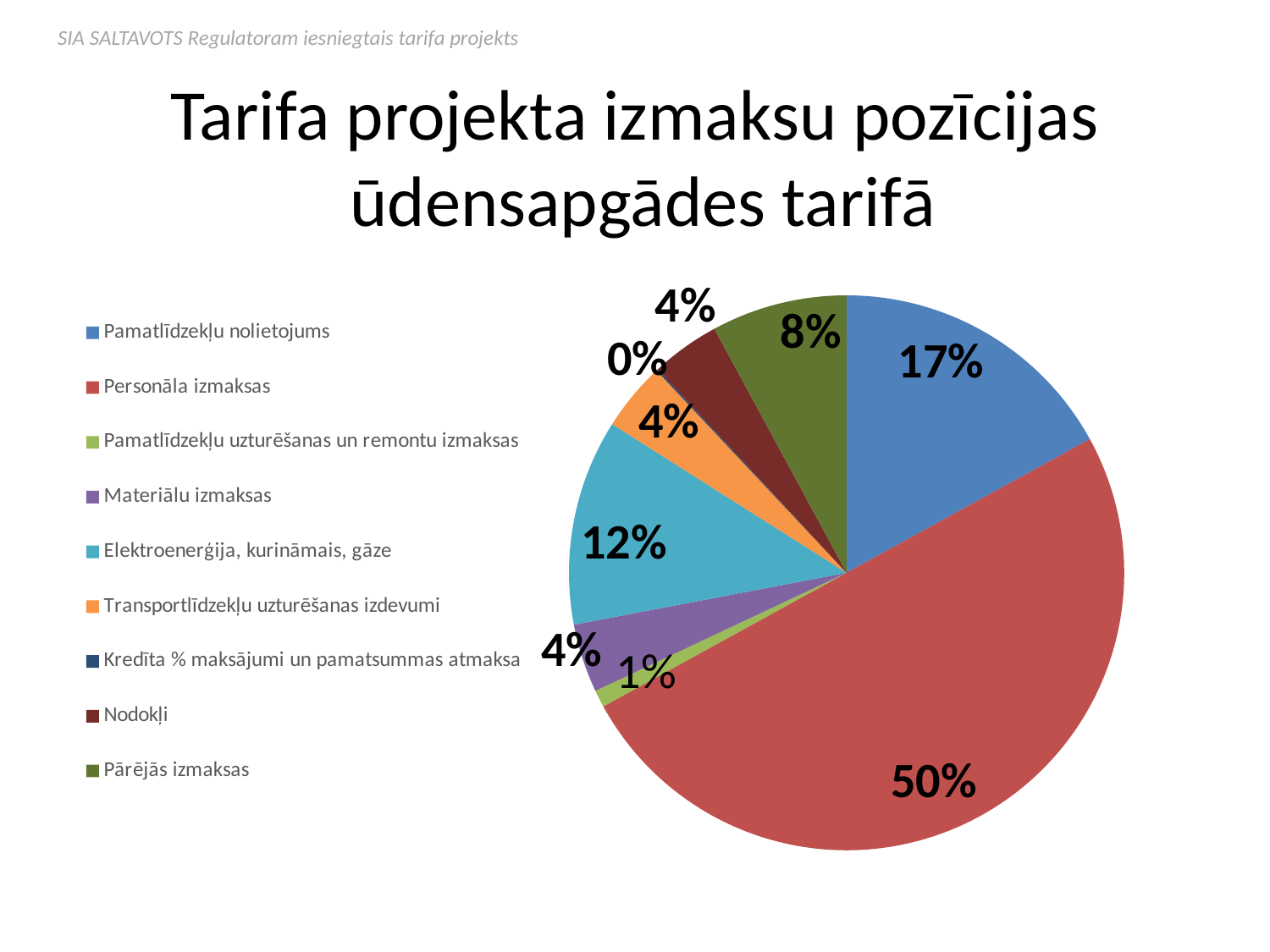
How many categories does the legend list? 9 What kind of chart is shown on the slide? Pie chart Which category has the largest share of the pie? Personāla izmaksas Which has a larger share, Elektroenerģija, kurināmais, gāze or Pārējās izmaksas? Elektroenerģija, kurināmais, gāze Which category has the smallest share of the pie? Kredīta % maksājumi un pamatsummas atmaksa What share of the pie does Pamatlīdzekļu uzturēšanas un remontu izmaksas represent? 1% What is the difference in percentage points between the shares of Personāla izmaksas and Pamatlīdzekļu nolietojums? 33 percentage points What share of the pie does Pamatlīdzekļu nolietojums represent? 17% What share of the pie does Personāla izmaksas represent? 50%